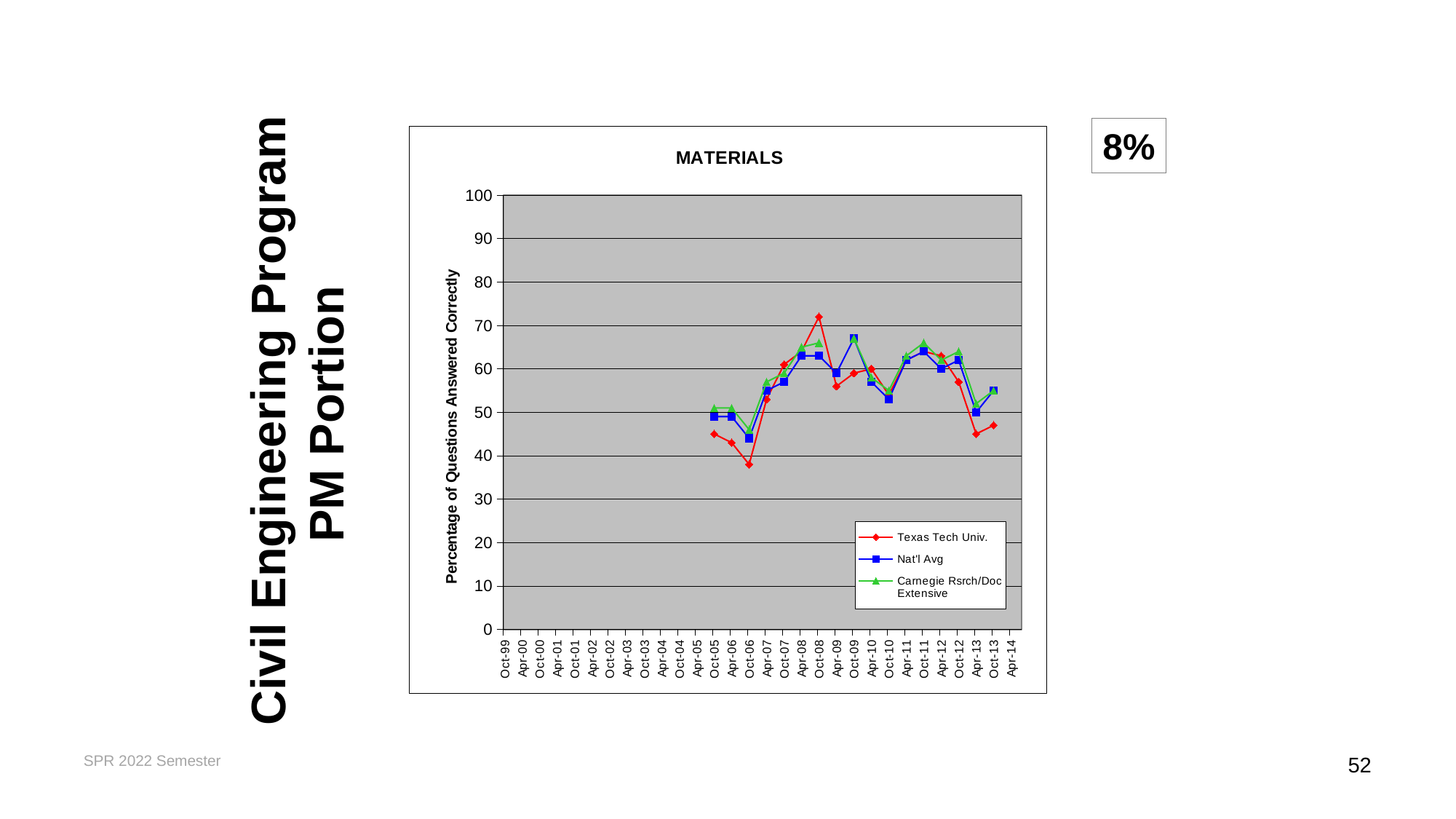
Is the value for Texas Tech Univ. at Oct-08 greater or less than 60? greater At Oct-08, which is larger: Texas Tech Univ. or Nat'l Avg? Texas Tech Univ. Is the value for Nat'l Avg at Oct-06 greater or less than 50? less Does the Texas Tech Univ. series rise or fall from Oct-05 to Oct-06? fall How many series does the legend list? 3 What is the label on the vertical axis of the chart? Percentage of Questions Answered Correctly At which date does the Texas Tech Univ. series reach its lowest value? Oct-06 What is the title of the chart? MATERIALS Is the value for Nat'l Avg at Oct-09 greater or less than 60? greater At which date does the Texas Tech Univ. series reach its highest value? Oct-08 What kind of chart is shown on the slide? line chart